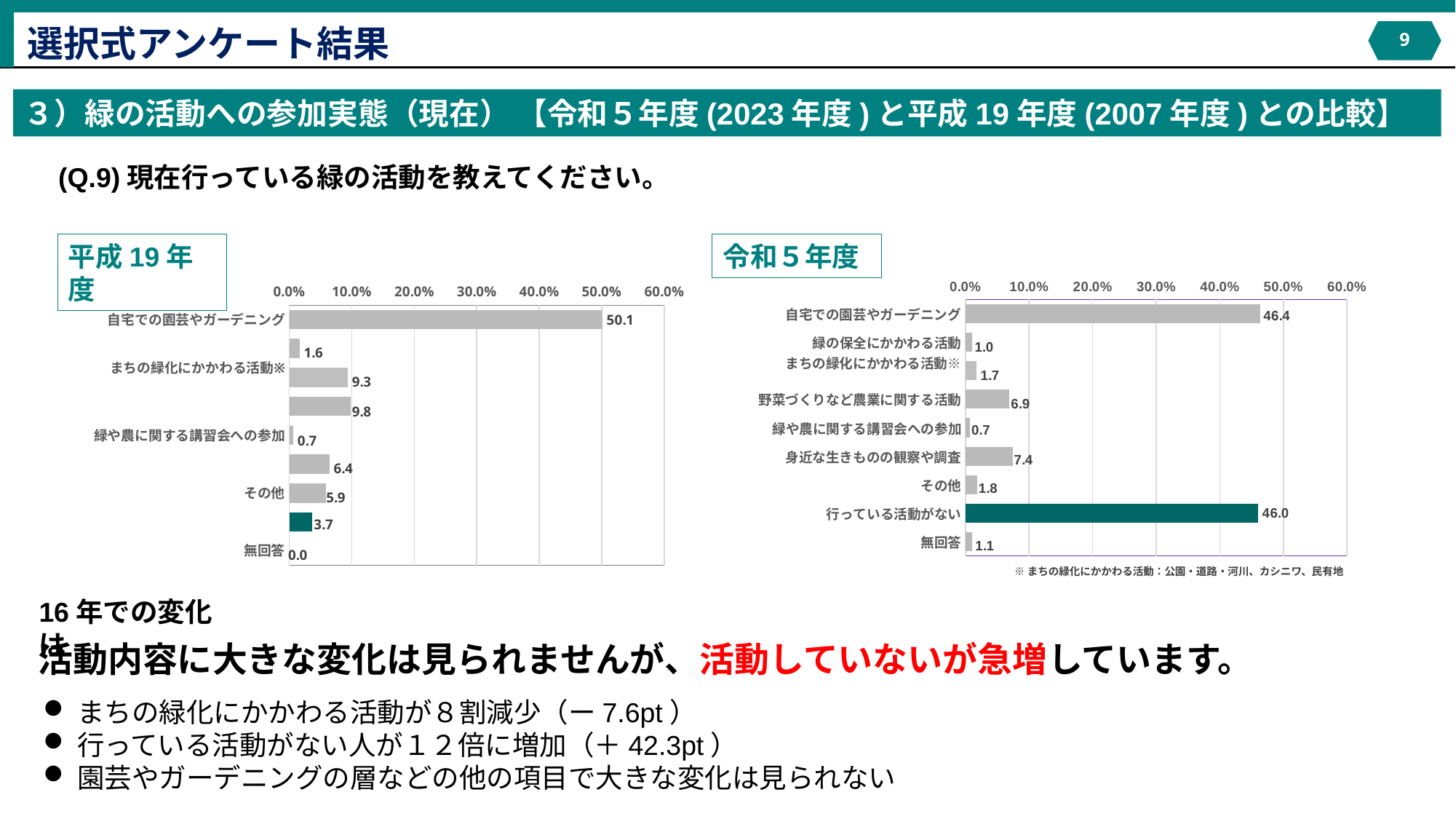
In the 令和5年度 chart, what is the value for 行っている活動がない? 46.0 In the 令和5年度 chart, is the value for 行っている活動がない greater or less than 40.0%? greater What is the difference between the 自宅での園芸やガーデニング values in the 平成19年度 chart and the 令和5年度 chart? 3.7 In the 令和5年度 chart, which category has the highest value? 自宅での園芸やガーデニング In the 平成19年度 chart, what is the value for 自宅での園芸やガーデニング? 50.1 In the 平成19年度 chart, which category has the lowest value? 無回答 In the 平成19年度 chart, what is the value for まちの緑化にかかわる活動※? 9.3 In the 令和5年度 chart, which is larger: 身近な生きものの観察や調査 or 野菜づくりなど農業に関する活動? 身近な生きものの観察や調査 What type of chart is the 平成19年度 chart? bar chart In the 令和5年度 chart, which category has the lowest value? 緑や農に関する講習会への参加 In the 令和5年度 chart, what is the value for 自宅での園芸やガーデニング? 46.4 How many bars are plotted in the 令和5年度 chart? 9